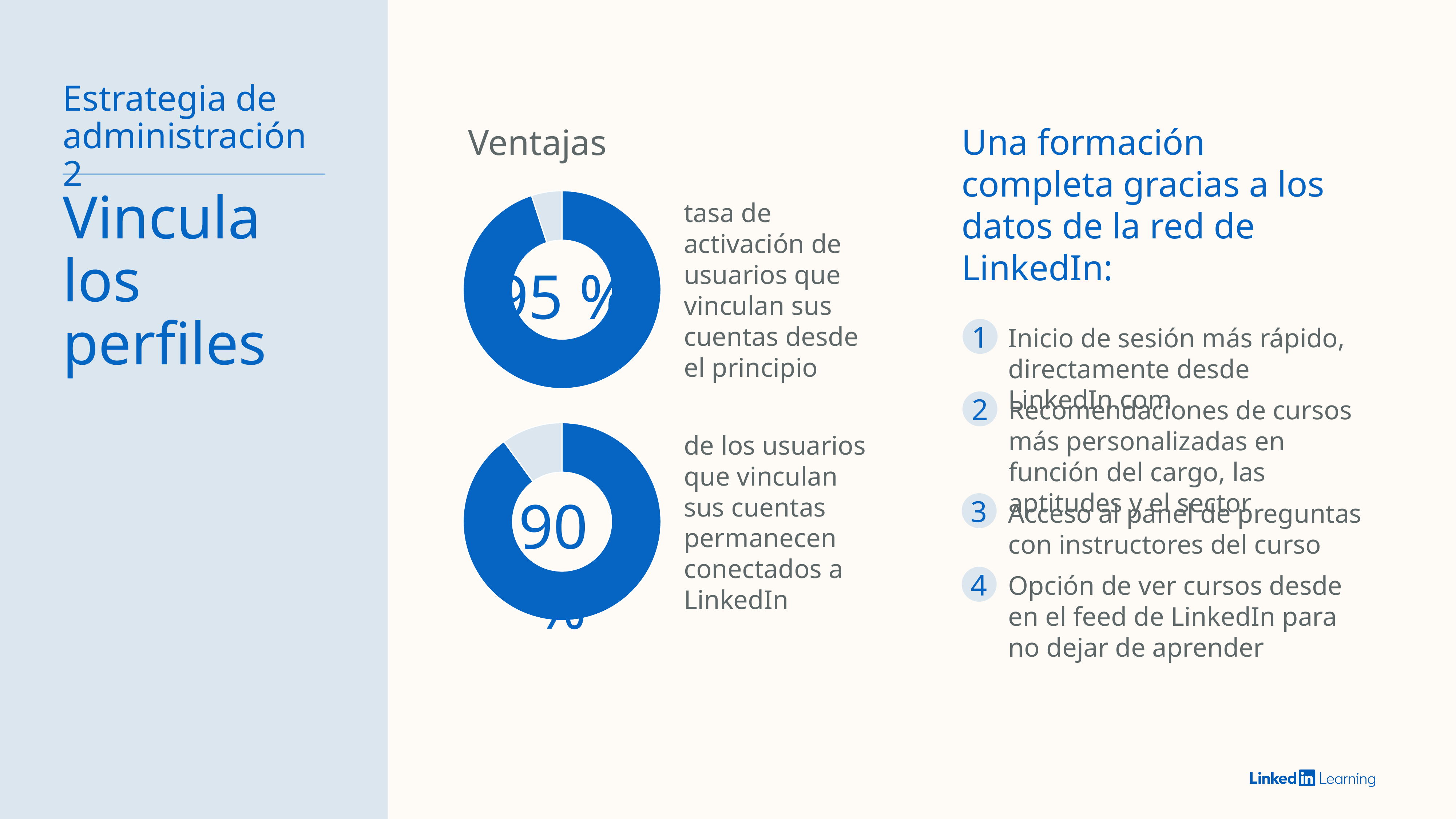
In the top donut chart, what share of the ring is filled in dark blue? 95 % How many donut charts are shown under the heading "Ventajas"? 2 In the top donut chart, what is the activation rate of users who link their accounts from the start? 95 % Which donut chart shows the larger value, the top one (activation rate) or the bottom one (users remaining connected)? Top (95 %) What colour is the filled portion of the donut charts on the slide? Blue What kind of chart is used to show the 95 % activation rate on the slide? Donut chart In the bottom donut chart, what percentage of users who link their accounts remain connected to LinkedIn? 90 % What is the difference between the value in the top donut chart (95 %) and the value in the bottom donut chart (90 %)? 5 percentage points Is the value shown in the bottom donut chart greater or less than 50 %? greater What heading appears above the two donut charts? Ventajas